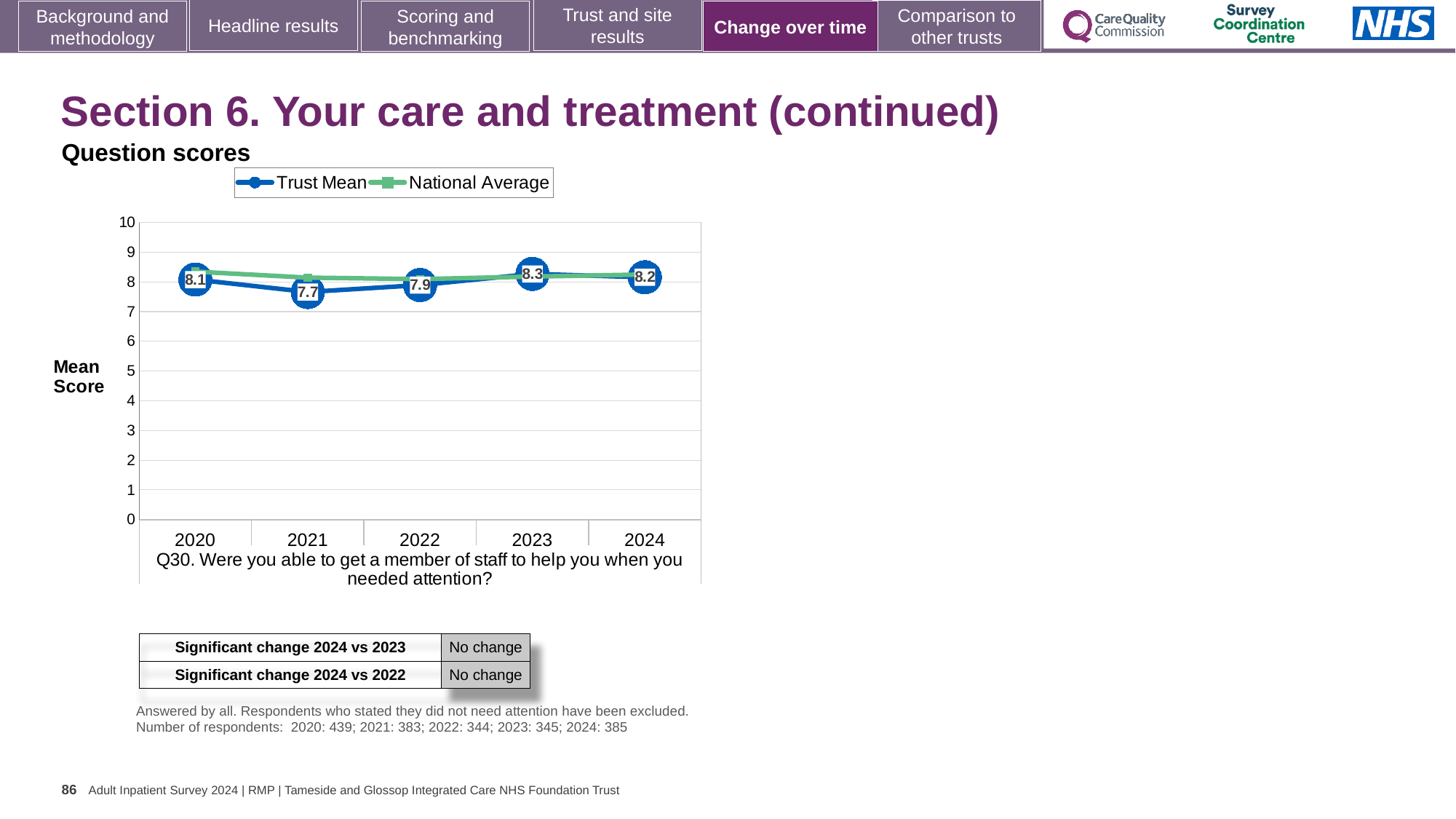
What is the difference between the Trust Mean scores for 2023 and 2021? 0.6 What is the Trust Mean score for 2021? 7.7 How many years are shown on the x axis? 5 How many series does the legend list? 2 Which year has the lowest Trust Mean score? 2021 What is the label on the y axis of the chart? Mean Score What kind of chart is shown on the slide? Line chart Which is larger, the Trust Mean score for 2020 or for 2022? 2020 Which year has the highest Trust Mean score? 2023 What is the Trust Mean score for 2024? 8.2 What is the Trust Mean score for 2023? 8.3 Is the National Average value for 2021 greater or less than 7? greater